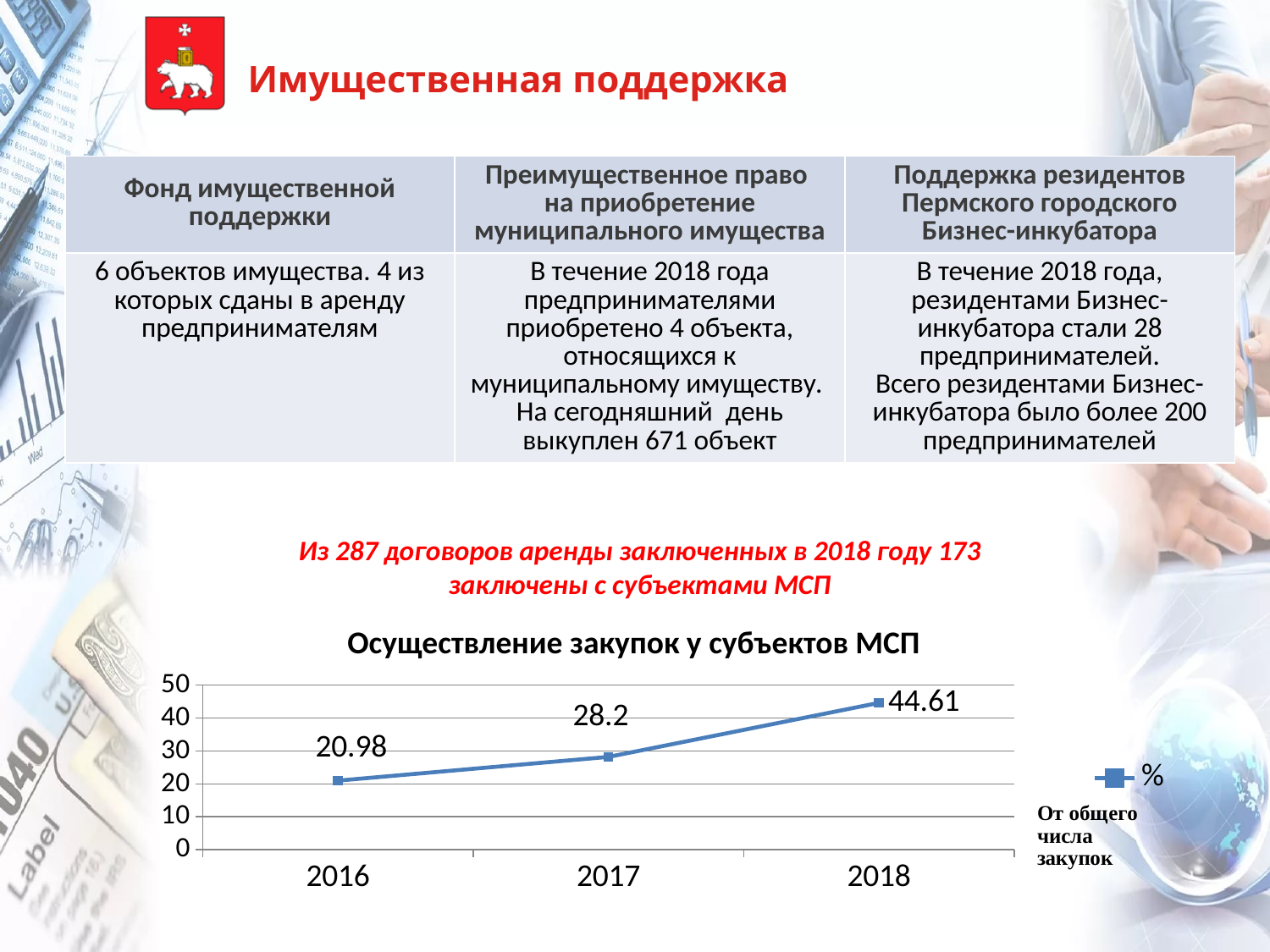
Which is larger, the value for 2017 or the value for 2018? 2018 What is the value for 2016 in the chart 'Осуществление закупок у субъектов МСП'? 20.98 Do the values rise or fall from 2016 to 2018? rise Which year has the lowest value in the chart? 2016 What is the difference between the values for 2017 and 2016? 7.22 Which year has the highest value in the chart? 2018 How many years are plotted on the x axis of the chart? 3 What is the value for 2018 in the chart? 44.61 What kind of chart is shown on the slide? line chart Is the value for 2018 greater or less than 40? greater What is the value for 2017 in the chart? 28.2 What is the difference between the values for 2018 and 2016? 23.63